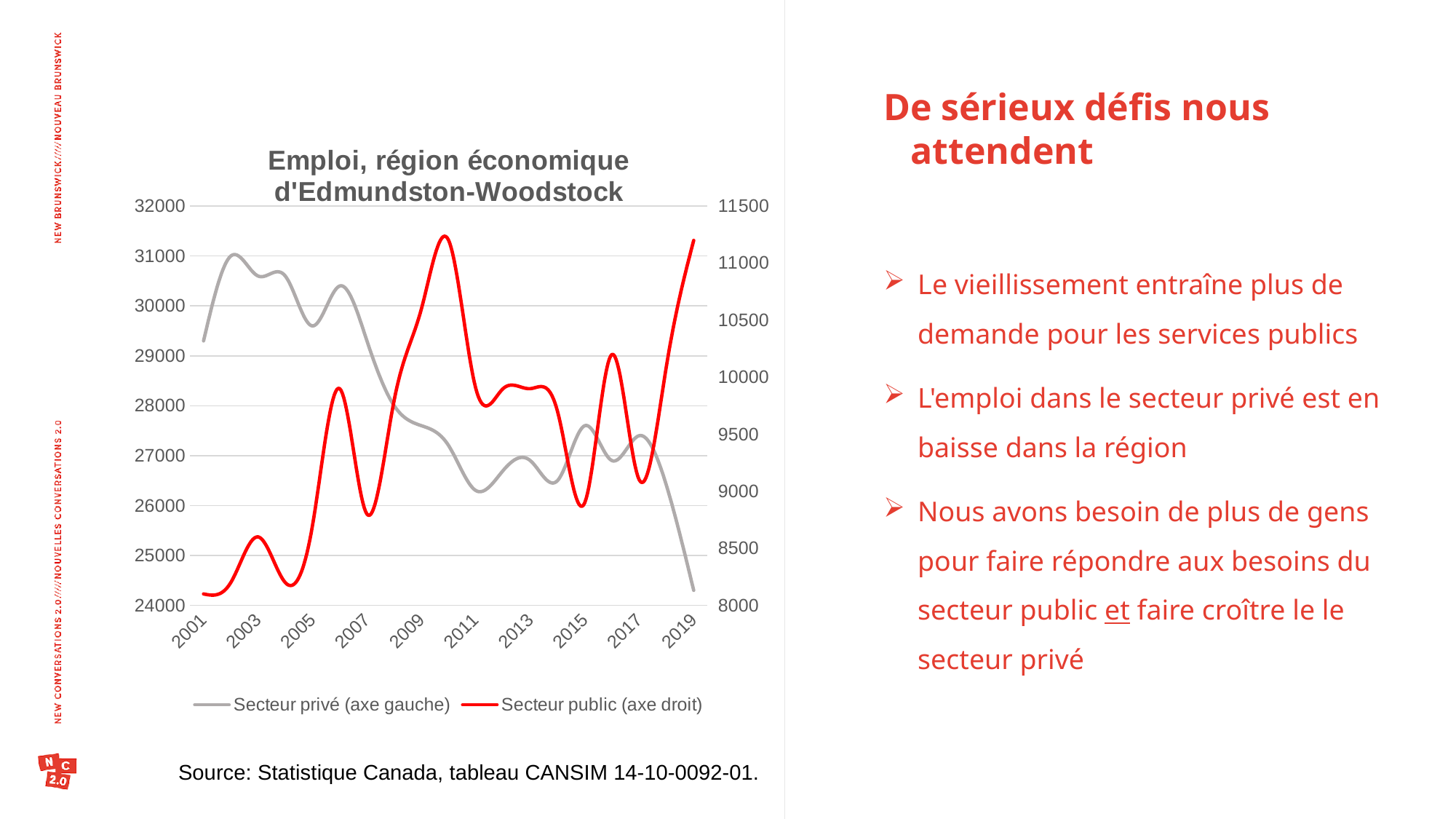
For 'Secteur privé', which is larger: the value in 2001 or the value in 2019? 2001 According to the legend, which axis is used for the 'Secteur public' series? Axe droit (right axis) Does the 'Secteur privé' series rise or fall overall from 2001 to 2019? Fall Is the value for 'Secteur privé' in 2001 greater or less than 29000? greater What kind of chart is shown on the slide? Line chart How many series does the chart's legend list? 2 Does the 'Secteur public' series rise or fall overall from 2001 to 2019? Rise Is the value for 'Secteur privé' in 2019 greater or less than 25000? less Is the value for 'Secteur public' in 2001 greater or less than 8500? less In which year shown on the x axis is the 'Secteur privé' series at its lowest? 2019 What is the title of the chart? Emploi, région économique d'Edmundston-Woodstock